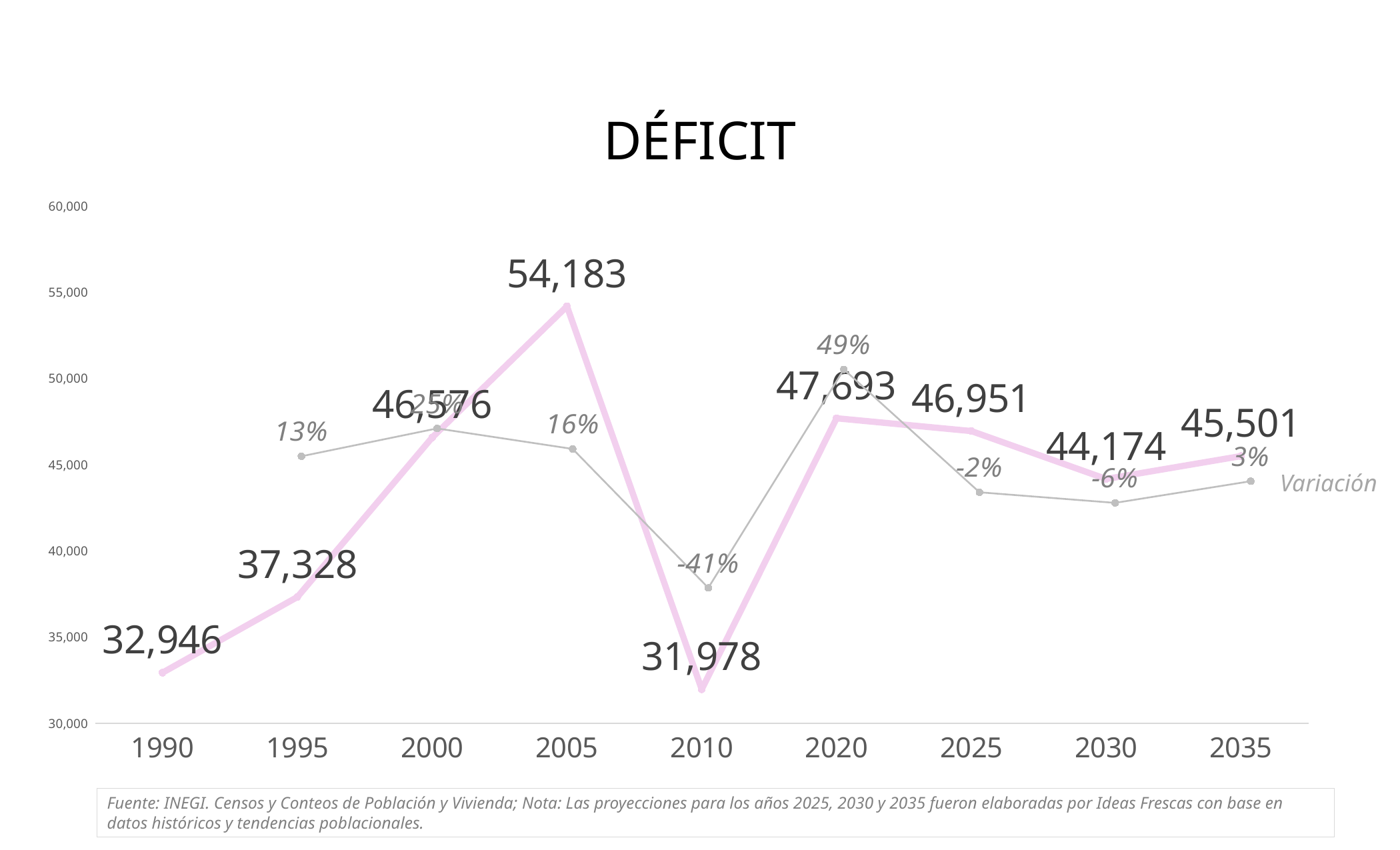
What is the déficit value for 2030? 44,174 What is the Variación value shown for 2020? 49% Which year has the highest déficit value? 2005 What is the déficit value for 2005? 54,183 How many years are shown on the x axis? 9 What is the difference between the déficit values for 2005 and 2010? 22,205 What is the Variación value shown for 2010? -41% What is the title of the chart? DÉFICIT Which is larger, the déficit value for 2020 or for 2025? 2020 What is the déficit value for 1990? 32,946 Which year has the lowest déficit value? 2010 What kind of chart is this? Line chart